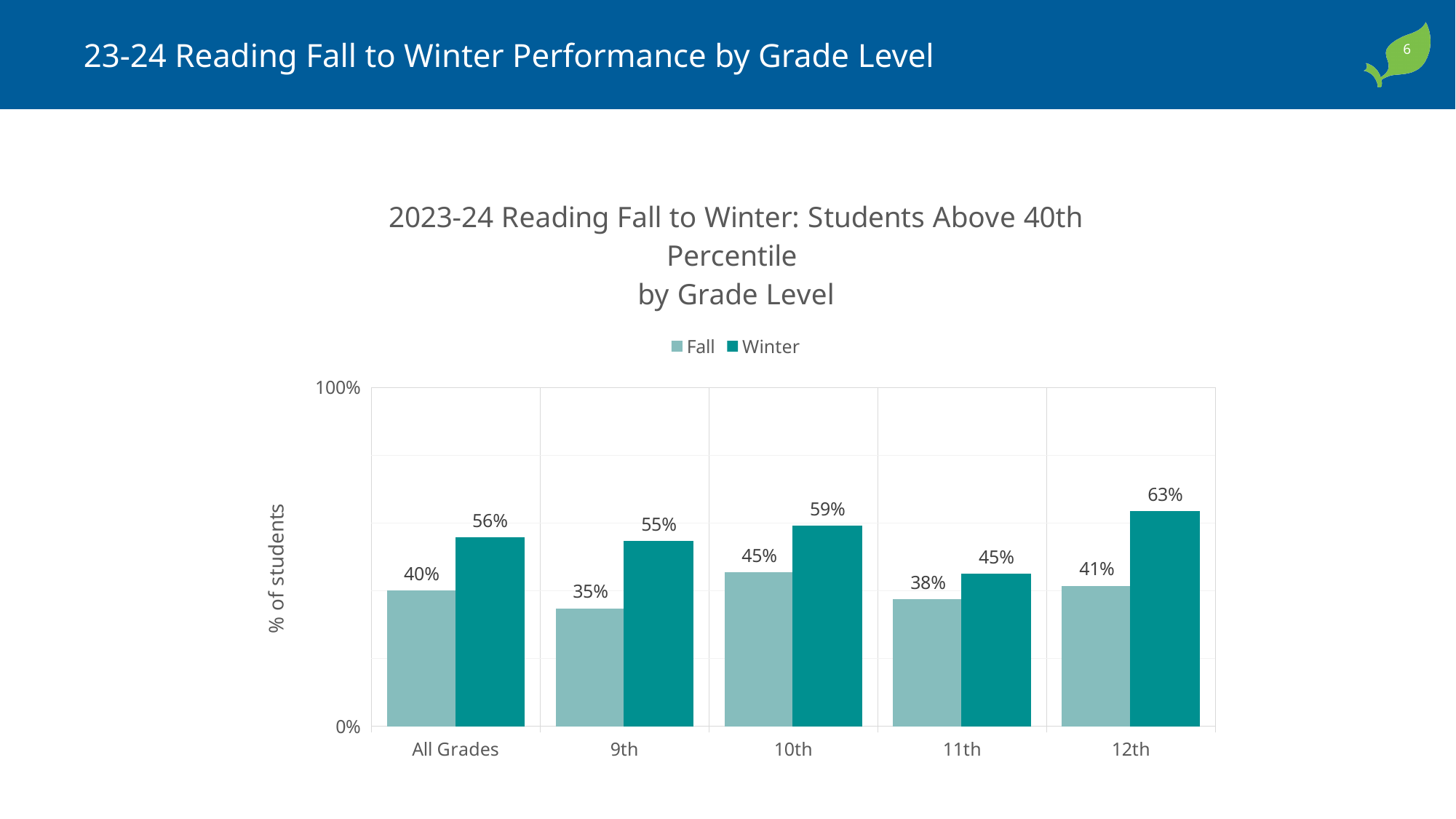
What is the Fall value for 9th grade? 35% Which grade level has the lowest Fall value? 9th What is the difference between the Winter values for 10th and 11th grade? 14% How many grade-level categories are shown on the x axis? 5 What is the Winter value for 12th grade? 63% What is the Fall value for All Grades? 40% Which is larger, the Fall value for 10th grade or the Fall value for 11th grade? 10th grade What is the difference between the Winter and Fall values for 12th grade? 22% What is the label on the vertical axis? % of students What kind of chart is shown on the slide? Bar chart How many series does the legend list? 2 Which grade level has the highest Winter value? 12th